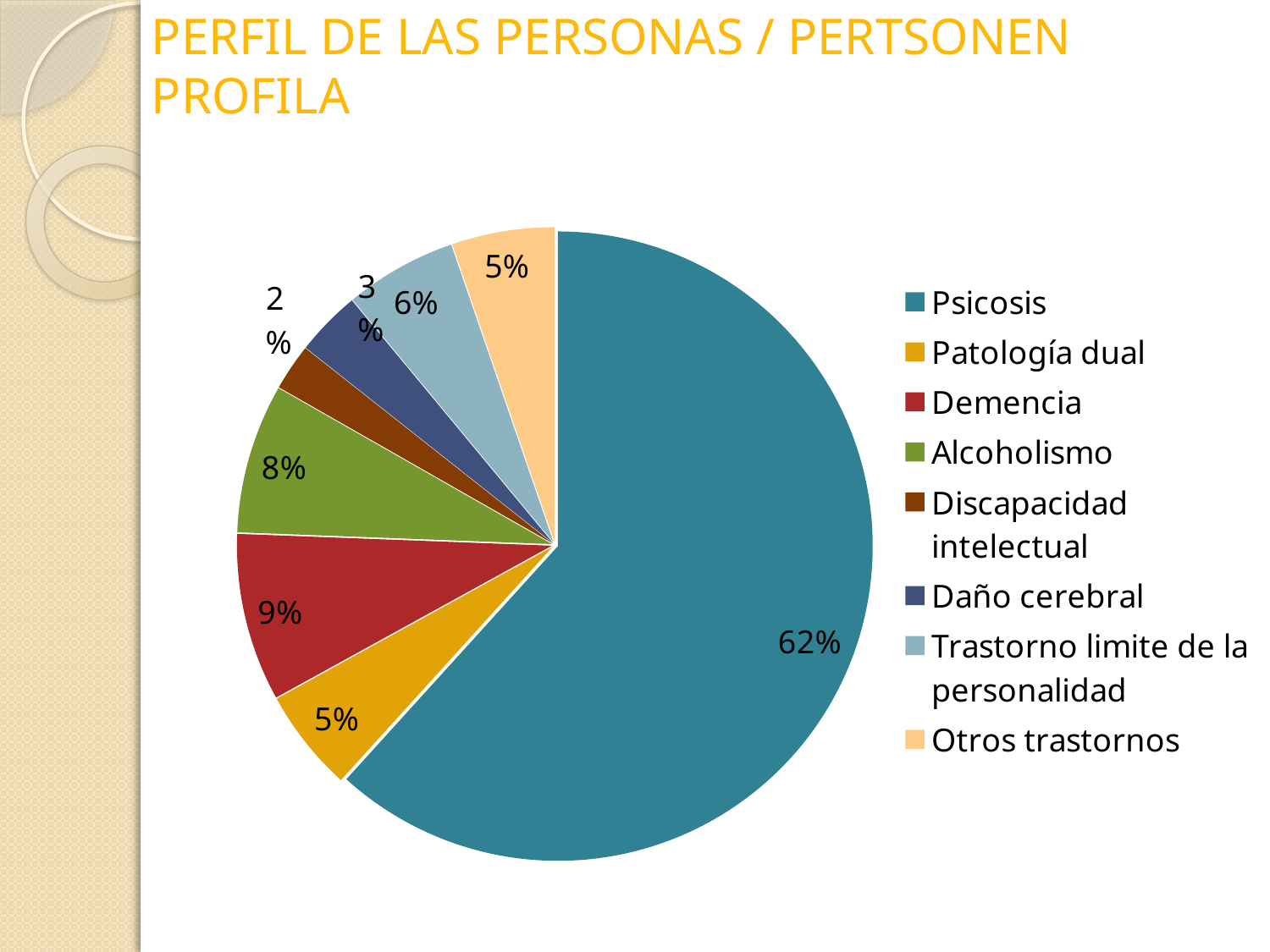
Which category has the smallest slice of the pie? Discapacidad intelectual What is the difference in percentage points between Demencia and Patología dual? 4 What colour is the slice for Otros trastornos? light orange Which category has the largest slice of the pie? Psicosis How many categories does the pie chart have? 8 What percentage is shown for Demencia? 9% Which is larger, the slice for Alcoholismo or the slice for Trastorno limite de la personalidad? Alcoholismo What percentage is shown for Daño cerebral? 3% What share of the pie does Psicosis represent? 62% What kind of chart is shown on the slide? pie chart What percentage is shown for Alcoholismo? 8% What percentage is shown for Trastorno limite de la personalidad? 6%